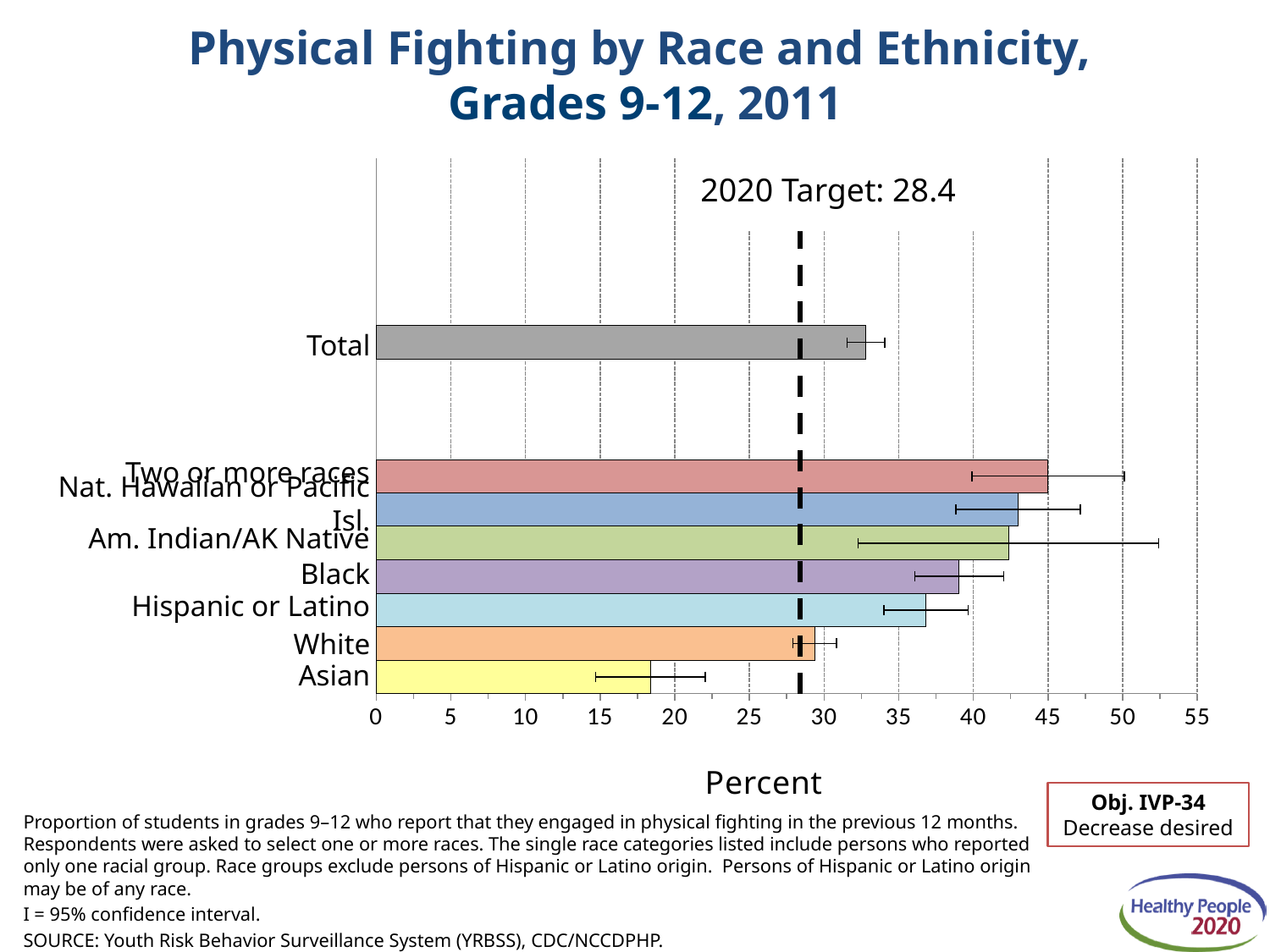
Is the value for Two or more races greater or less than 40? greater Is the value for Total greater or less than 30? greater Is the value for Black greater or less than 35? greater Which group has the highest percentage of physical fighting? Two or more races What is the label of the horizontal axis? Percent How many bars are plotted in the chart? 8 What is the 2020 Target value shown on the chart? 28.4 What type of chart is shown on the slide? bar chart Which group has a higher percentage, Black or White? Black Which group has the lowest percentage of physical fighting? Asian